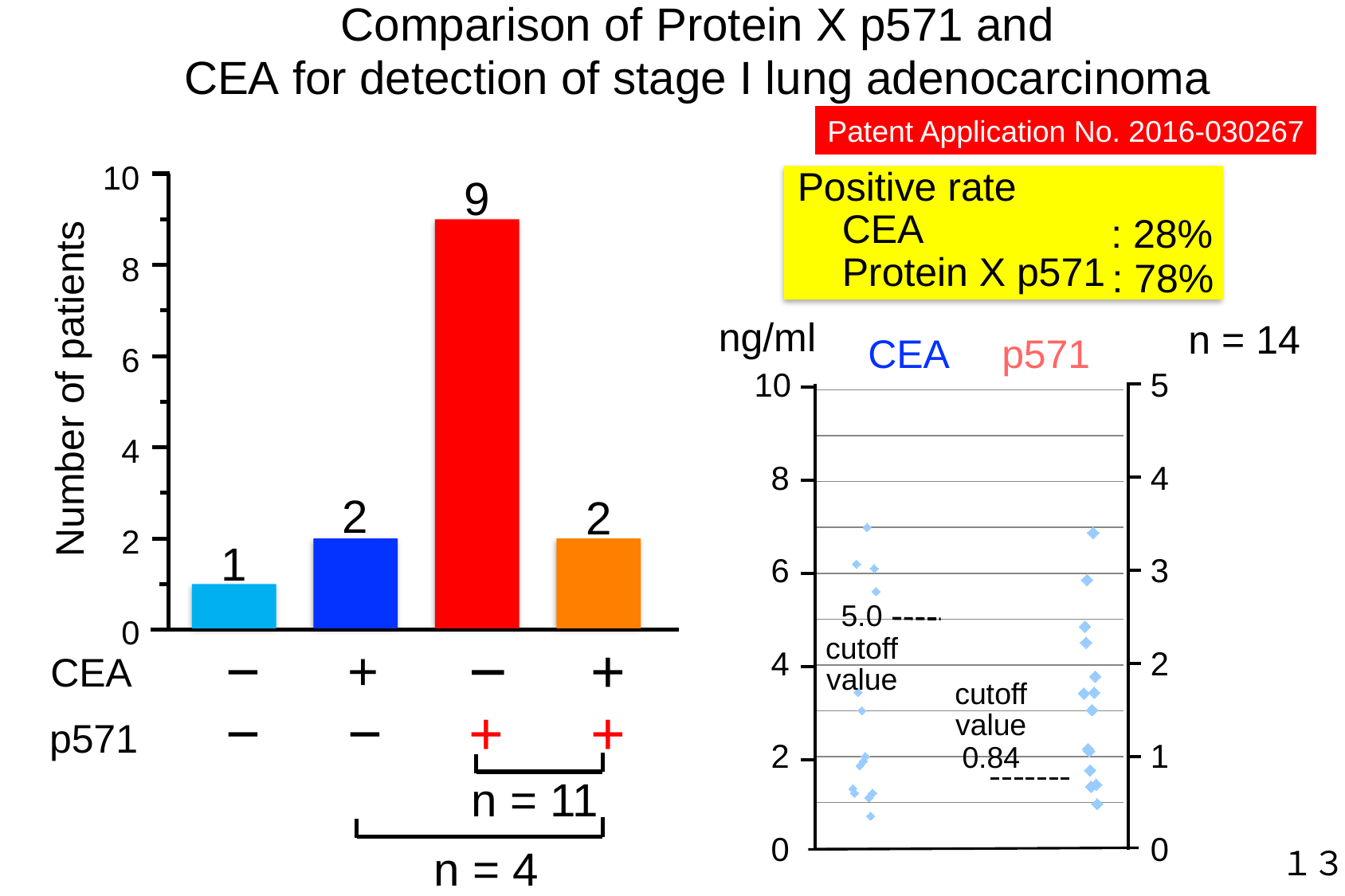
What type of chart is the chart on the left of the slide? Bar chart How many bars are shown in the bar chart on the left? 4 In the bar chart on the left, which group has the lowest number of patients? CEA negative, p571 negative In the bar chart on the left, how many patients are CEA negative and p571 negative? 1 In the bar chart on the left, which group has more patients: CEA−/p571+ or CEA+/p571+? CEA−/p571+ In the bar chart on the left, which group has the highest number of patients? CEA negative, p571 positive In the bar chart on the left, how many patients are CEA negative and p571 positive? 9 What is the label of the vertical axis of the bar chart on the left? Number of patients In the dot plot on the right, what is the cutoff value shown for CEA? 5.0 In the bar chart on the left, how many patients are CEA positive and p571 negative? 2 In the bar chart on the left, what is the difference in number of patients between the CEA−/p571+ group and the CEA−/p571− group? 8 What is the total number of patients across all four bars in the bar chart on the left? 14